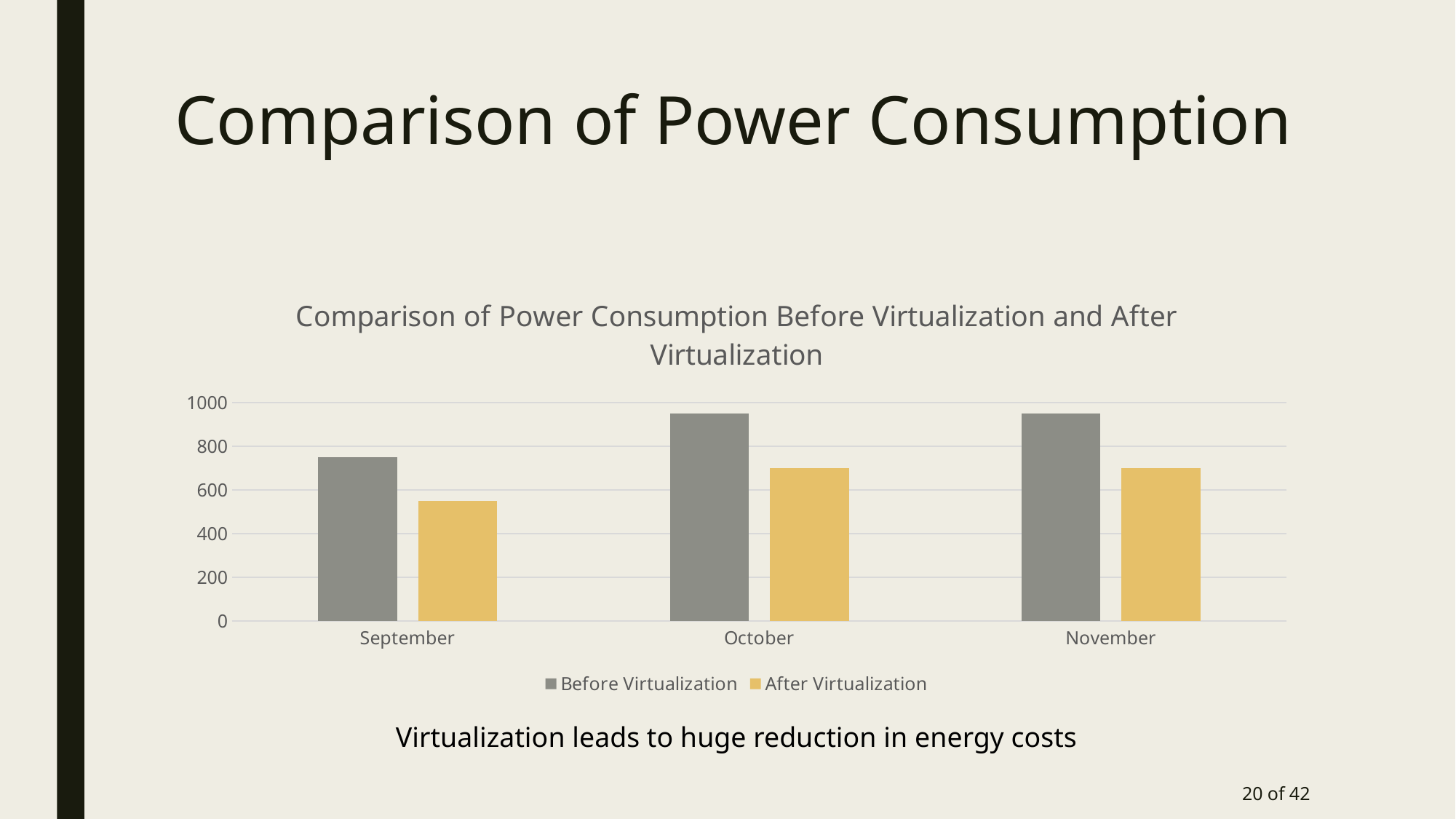
In October, which is larger: the Before Virtualization value or the After Virtualization value? Before Virtualization How many months are shown on the x axis? 3 How many series does the legend list? 2 Which month has the lowest After Virtualization value? September Is the After Virtualization value for November greater or less than 800? less Is the Before Virtualization value for October greater or less than 800? greater Is the After Virtualization value for September greater or less than 600? less What kind of chart is shown on the slide? bar chart What colour are the After Virtualization bars? yellow Which month has the lowest Before Virtualization value? September Do the Before Virtualization values rise or fall from September to October? rise